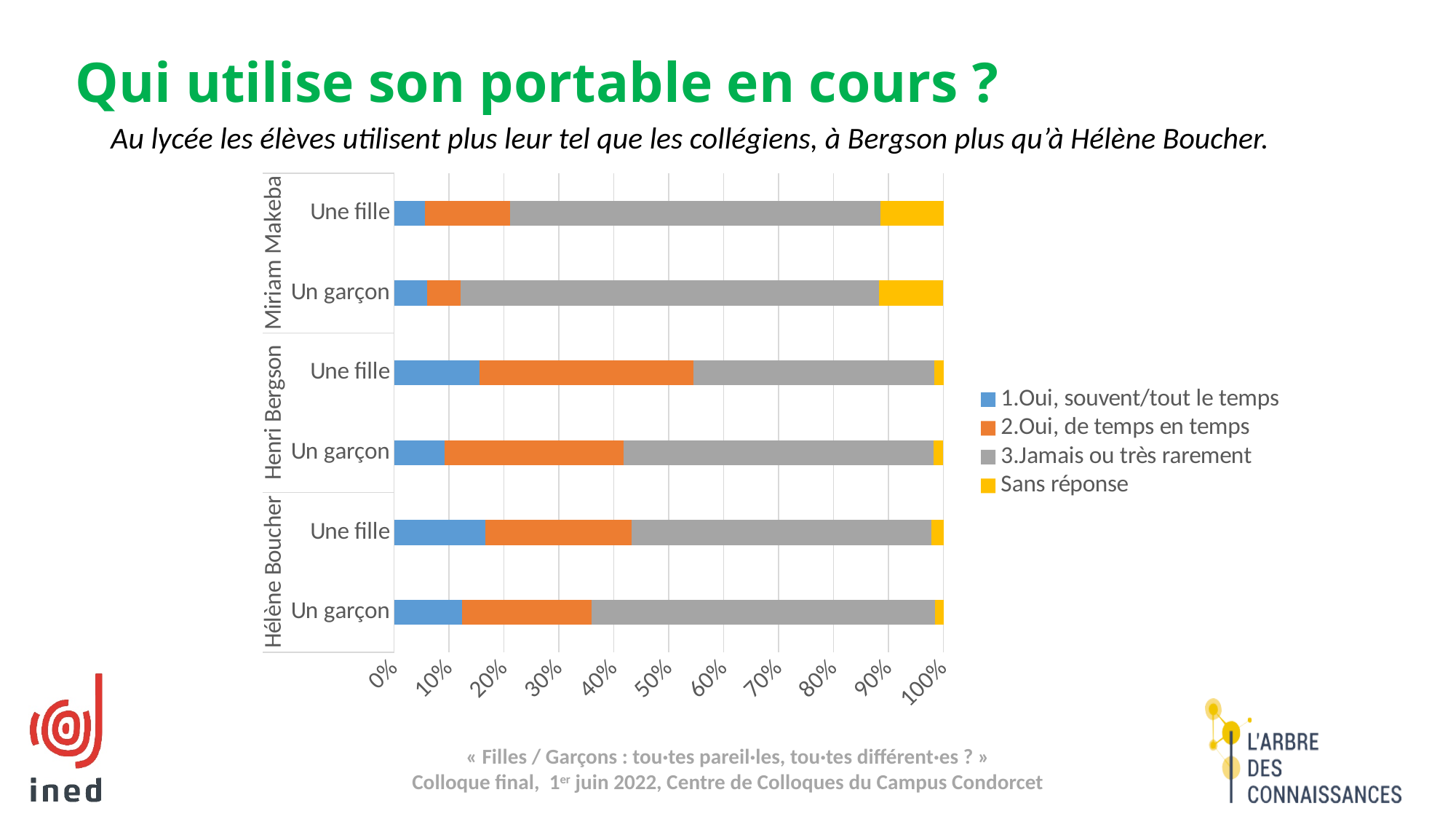
Is the '1.Oui, souvent/tout le temps' share for 'Une fille' at Miriam Makeba greater or less than 10%? less What is the total of each stacked bar in the chart? 100% Which bar has the smallest '2.Oui, de temps en temps' segment? Un garçon at Miriam Makeba Is the '1.Oui, souvent/tout le temps' share for 'Une fille' at Henri Bergson greater or less than 10%? greater Which colour represents 'Sans réponse' in the chart? Yellow What kind of chart is shown on the slide? Stacked bar chart Which bar has the larger '3.Jamais ou très rarement' segment: 'Une fille' at Miriam Makeba or 'Une fille' at Henri Bergson? Une fille at Miriam Makeba How many series does the legend list? 4 Which bar has the larger 'Sans réponse' segment: 'Un garçon' at Miriam Makeba or 'Un garçon' at Hélène Boucher? Un garçon at Miriam Makeba How many bars are plotted in the chart? 6 What is the title of the slide containing the chart? Qui utilise son portable en cours ? Which bar has the largest '2.Oui, de temps en temps' segment? Une fille at Henri Bergson